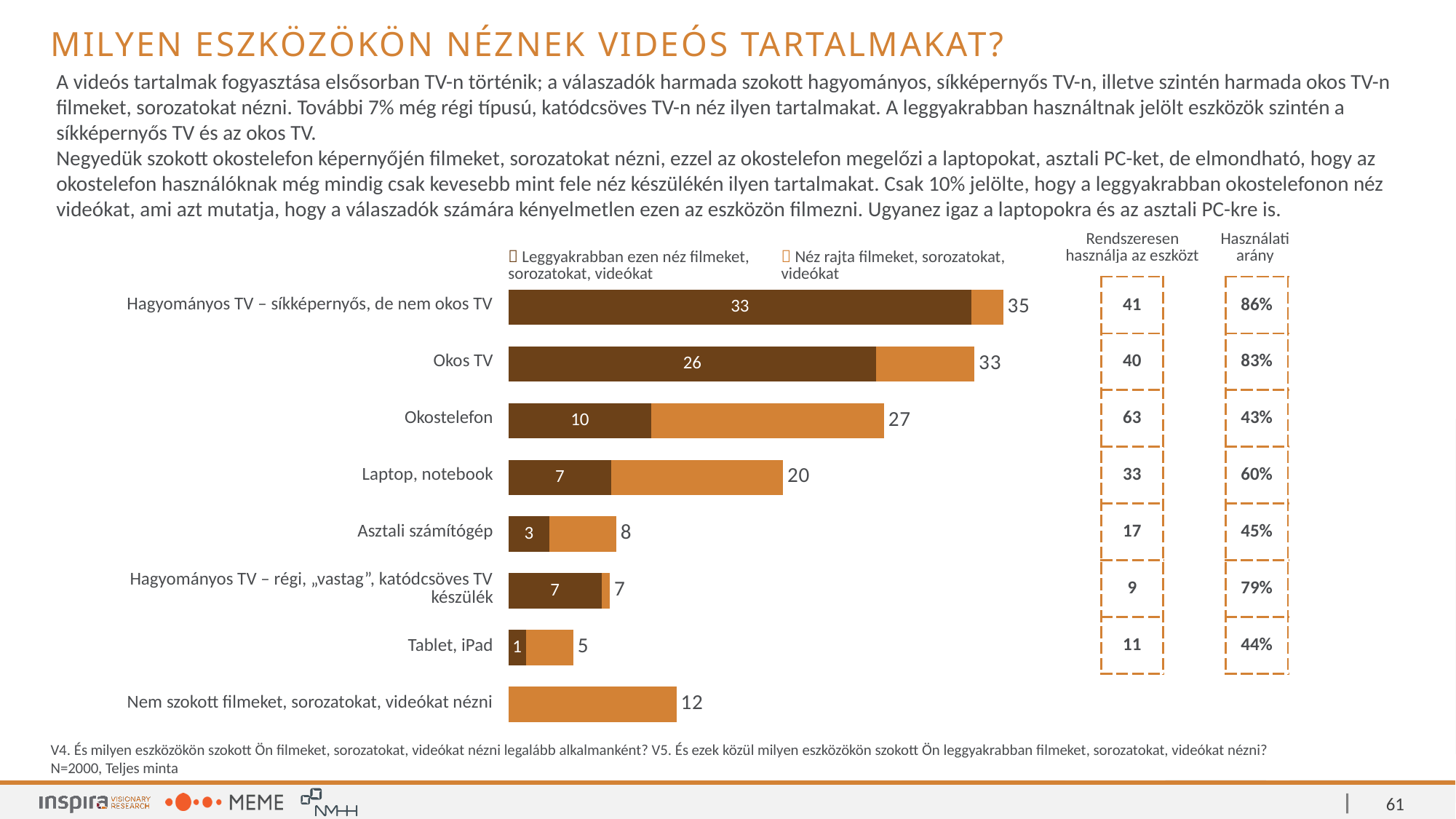
Which category has the highest value in the 'Néz rajta filmeket, sorozatokat, videókat' series? Hagyományos TV – síkképernyős, de nem okos TV How many categories are plotted in the bar chart? 8 What is the 'Rendszeresen használja az eszközt' value shown for 'Okostelefon'? 63 What is the value of the 'Néz rajta filmeket, sorozatokat, videókat' series for 'Okostelefon'? 27 What kind of chart is shown on the slide? bar chart What is the difference between the 'Néz rajta filmeket, sorozatokat, videókat' values for 'Laptop, notebook' and 'Asztali számítógép'? 12 What is the value of the 'Leggyakrabban ezen néz filmeket, sorozatokat, videókat' series for 'Okos TV'? 26 What is the 'Használati arány' value shown for 'Okos TV'? 83% Which category has the lowest value in the 'Leggyakrabban ezen néz filmeket, sorozatokat, videókat' series? Tablet, iPad How many series does the chart legend list? 2 Which is larger in the 'Leggyakrabban ezen néz filmeket, sorozatokat, videókat' series: 'Okostelefon' or 'Laptop, notebook'? Okostelefon What is the value of the 'Leggyakrabban ezen néz filmeket, sorozatokat, videókat' series for 'Asztali számítógép'? 3